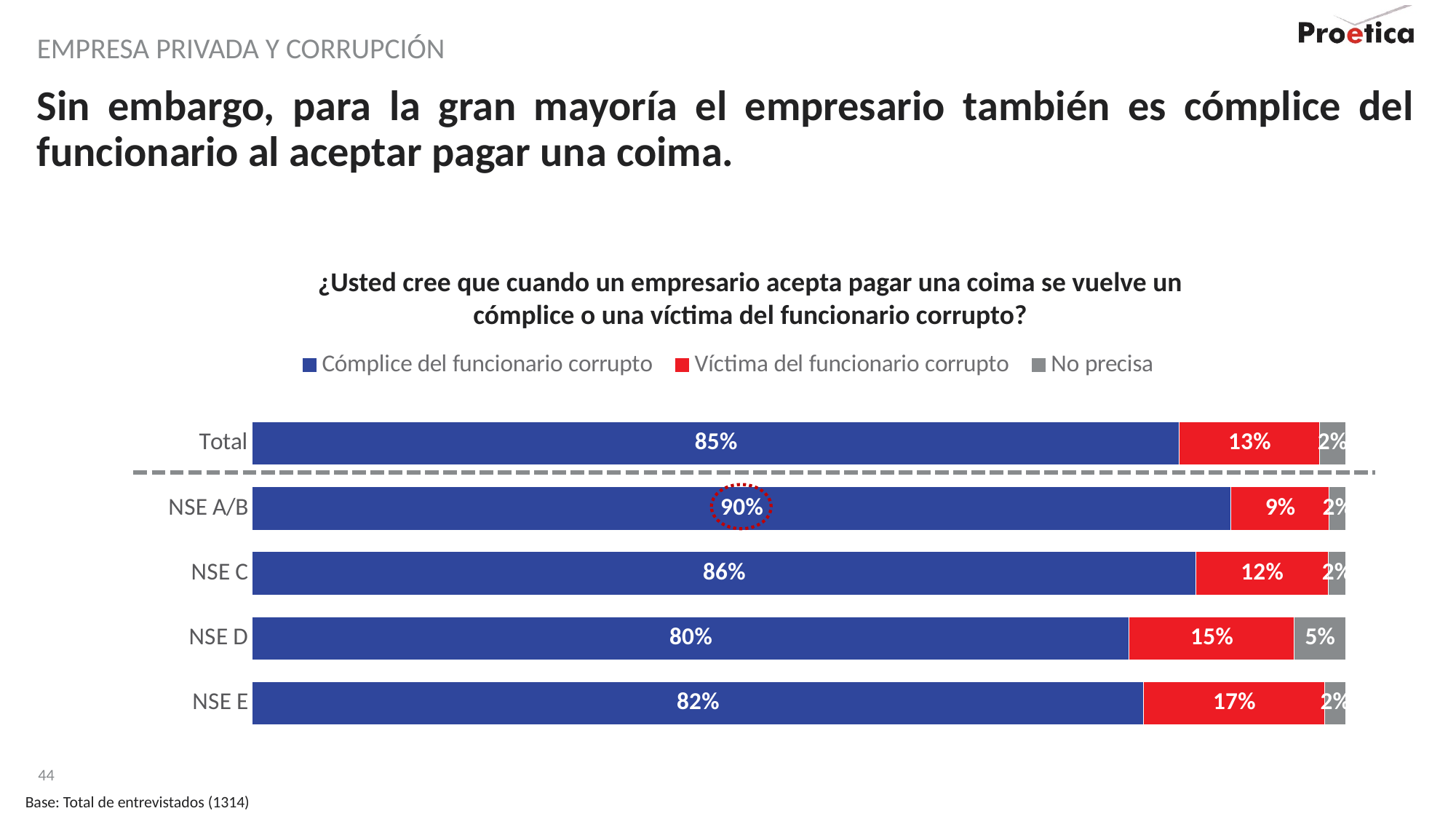
Which category has the lowest 'Cómplice del funcionario corrupto' value? NSE D What colour represents 'Víctima del funcionario corrupto' in the chart? Red Which is larger: the 'Víctima del funcionario corrupto' value for NSE C or for NSE D? NSE D What kind of chart is shown on the slide? Stacked bar chart What is the 'No precisa' value for NSE D? 5% What is the 'Víctima del funcionario corrupto' value for NSE E? 17% What is the difference between the 'Cómplice del funcionario corrupto' values for NSE A/B and NSE D? 10 percentage points What percentage of Total respondents answered 'Cómplice del funcionario corrupto'? 85% Which category has the highest 'Víctima del funcionario corrupto' value? NSE E How many series does the legend list? 3 Which category has the highest 'Cómplice del funcionario corrupto' value? NSE A/B How many categories are shown on the chart? 5